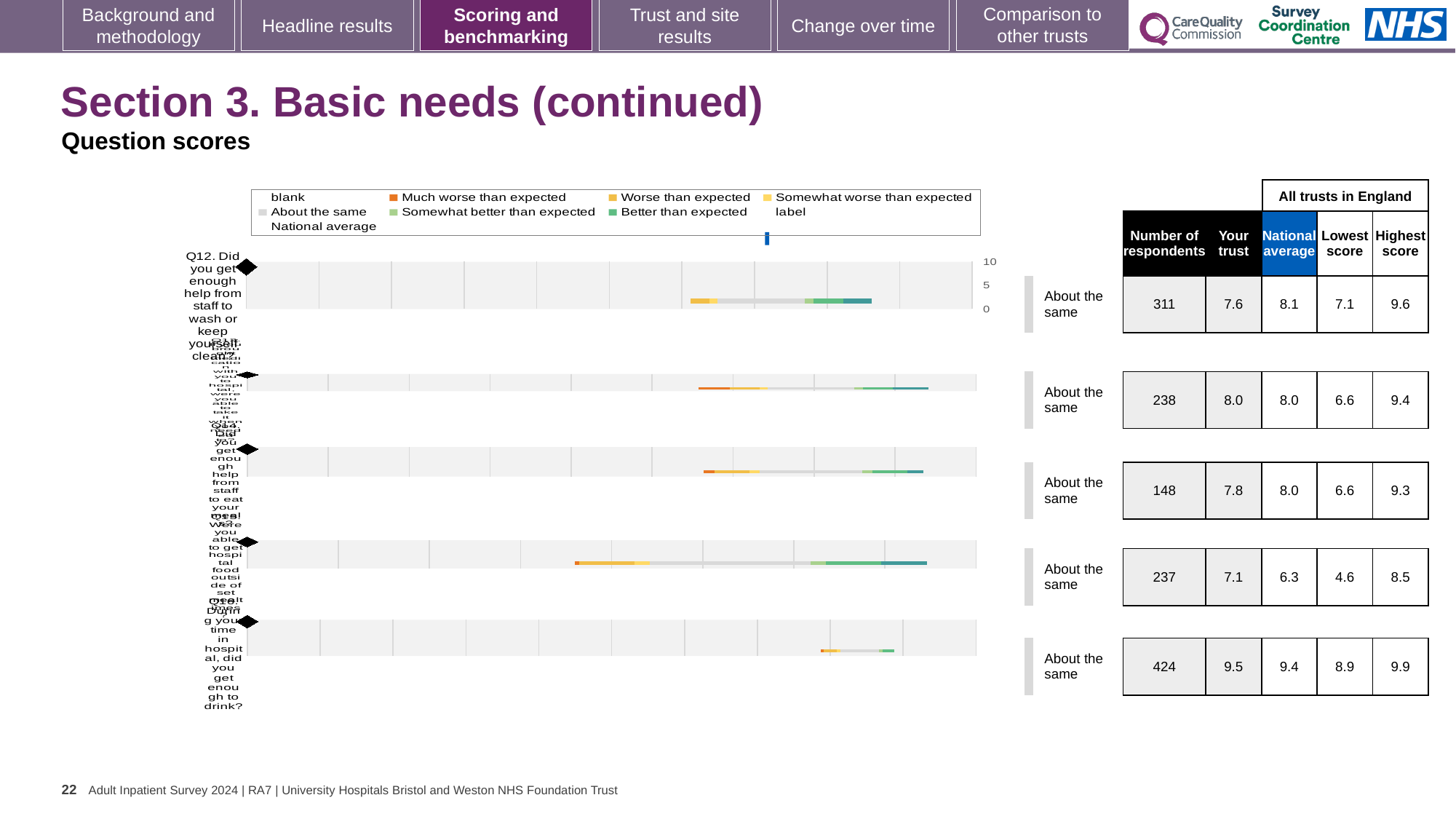
What is the 'Your trust' score for the bottom row of the chart (Q16, getting enough to drink)? 9.5 What benchmark category is shown for every question row on the slide? About the same How many question rows (bars) are plotted in the chart? 5 What is the title of the slide containing the chart? Section 3. Basic needs (continued) How many respondents answered Q12 (help from staff to wash or keep yourself clean)? 311 What is the difference between the national average and the 'Your trust' score for Q12? 0.5 What kind of chart is shown on the slide? bar chart What is the 'Your trust' score for Q12 (Did you get enough help from staff to wash or keep yourself clean?)? 7.6 Which row of the chart has the fewest respondents? the third row (Q14), 148 For the fourth row of the chart (Q15), which is larger: the 'Your trust' score or the national average? Your trust (7.1) What is the national average score for Q12 (help from staff to wash or keep yourself clean)? 8.1 Which row of the chart has the highest 'Your trust' score? the bottom row (Q16), 9.5